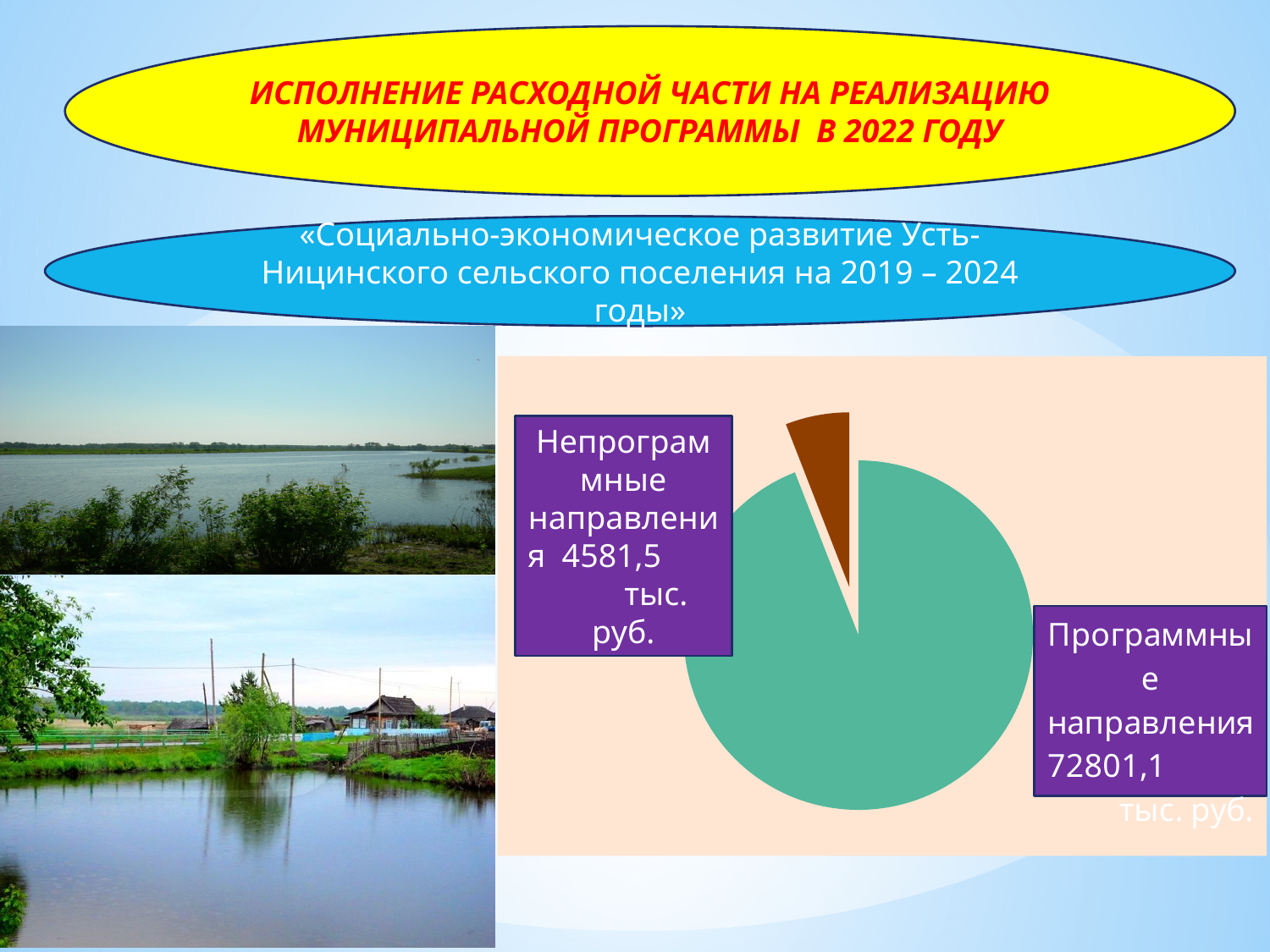
Which category has the smallest slice in the pie chart? Непрограммные направления What colour is the slice for Непрограммные направления? brown What is the value for Программные направления in the pie chart? 72801,1 тыс. руб. What is the value for Непрограммные направления in the pie chart? 4581,5 тыс. руб. Which is larger: Программные направления or Непрограммные направления? Программные направления What colour is the slice for Программные направления? green How many slices does the pie chart have? 2 What is the difference between Программные направления and Непрограммные направления? 68219,6 тыс. руб. Which category has the largest slice in the pie chart? Программные направления What kind of chart is shown on the slide? pie chart What is the total of the two slices in the pie chart? 77382,6 тыс. руб.